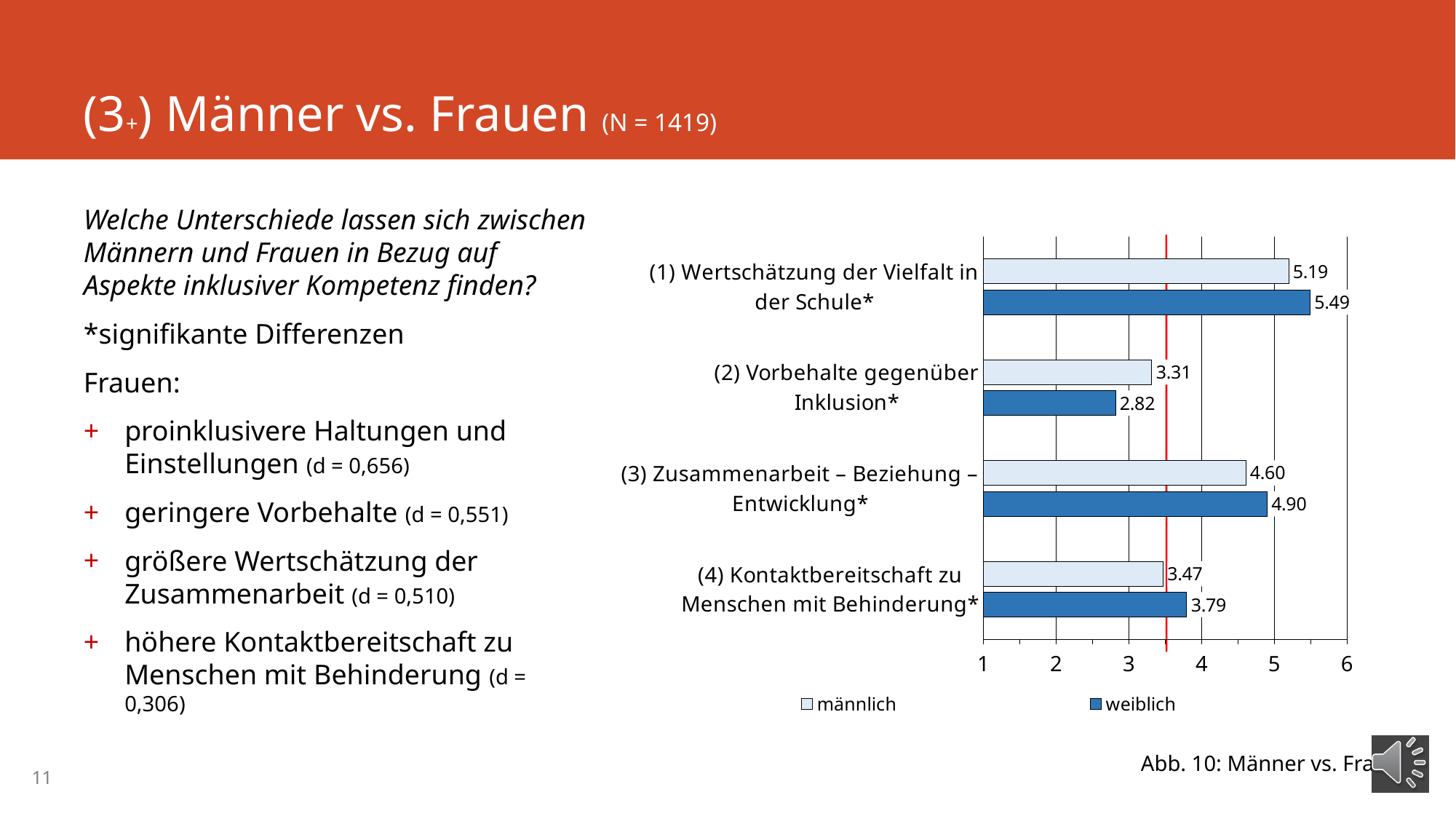
How many categories are shown on the chart? 4 What is the value for weiblich on "(3) Zusammenarbeit – Beziehung – Entwicklung*"? 4.90 Which is larger for "(2) Vorbehalte gegenüber Inklusion*": the männlich value or the weiblich value? männlich What kind of chart is shown on the slide? bar chart What is the value for männlich on "(1) Wertschätzung der Vielfalt in der Schule*"? 5.19 Is the weiblich value for "(4) Kontaktbereitschaft zu Menschen mit Behinderung*" greater or less than 4? less Which category has the highest value for weiblich? (1) Wertschätzung der Vielfalt in der Schule* Which category has the lowest value for männlich? (2) Vorbehalte gegenüber Inklusion* What is the value for männlich on "(4) Kontaktbereitschaft zu Menschen mit Behinderung*"? 3.47 How many series does the legend list? 2 What is the difference between the weiblich and männlich values for "(1) Wertschätzung der Vielfalt in der Schule*"? 0.30 What is the value for weiblich on "(2) Vorbehalte gegenüber Inklusion*"? 2.82